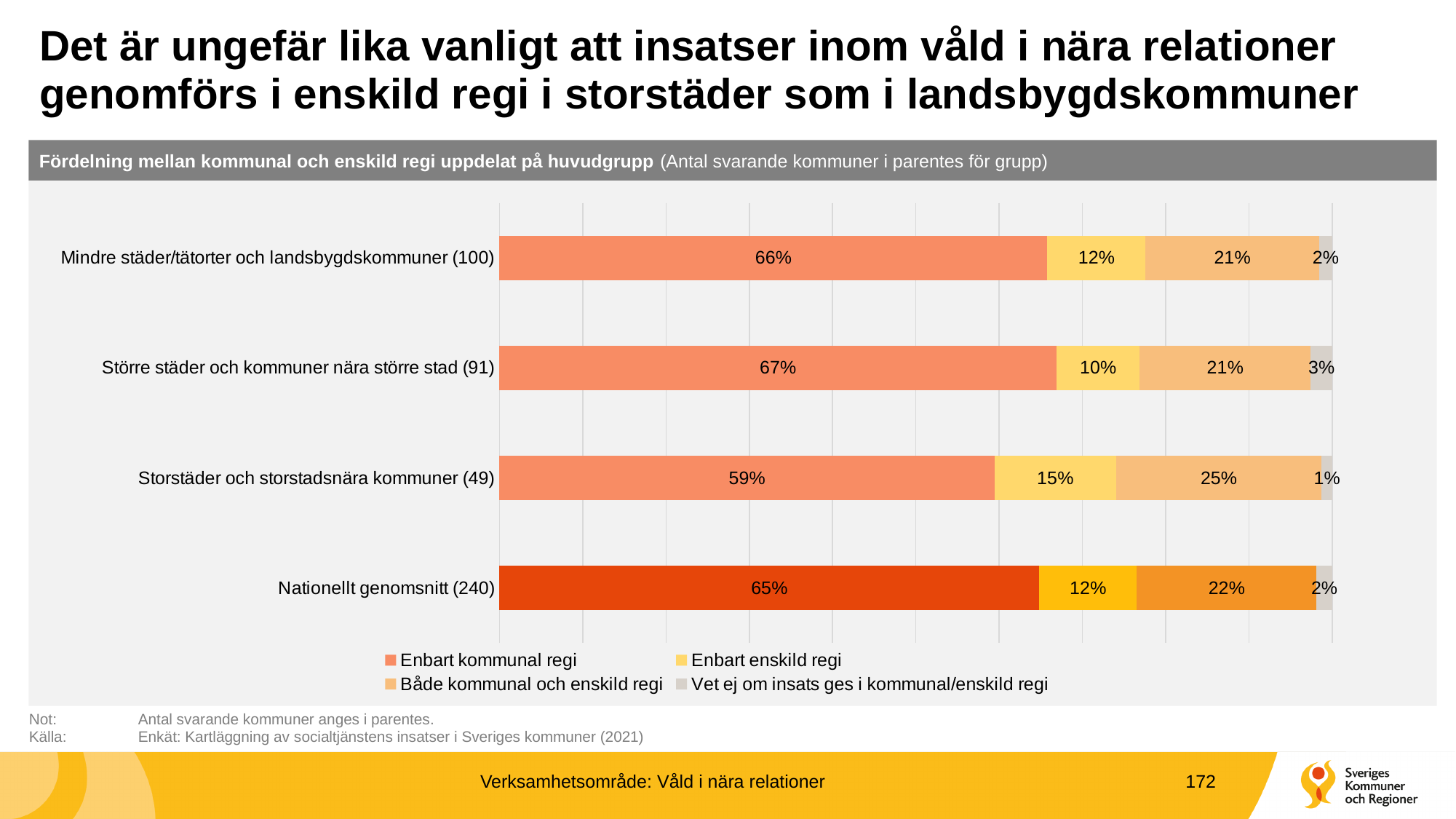
Which has a larger value for Både kommunal och enskild regi: Storstäder och storstadsnära kommuner (49) or Mindre städer/tätorter och landsbygdskommuner (100)? Storstäder och storstadsnära kommuner (49) What is the difference in Enbart enskild regi between Storstäder och storstadsnära kommuner (49) and Större städer och kommuner nära större stad (91)? 5 percentage points What is the value for Både kommunal och enskild regi for Nationellt genomsnitt (240)? 22% How many categories (bars) are shown in the chart? 4 Which category has the lowest value for Enbart kommunal regi? Storstäder och storstadsnära kommuner (49) What is the value for Vet ej om insats ges i kommunal/enskild regi for Större städer och kommuner nära större stad (91)? 3% What is the total of the printed values for the Storstäder och storstadsnära kommuner (49) bar? 100% What kind of chart is shown on the slide? Stacked bar chart Which category has the highest value for Enbart kommunal regi? Större städer och kommuner nära större stad (91) What is the value for Enbart kommunal regi for Storstäder och storstadsnära kommuner (49)? 59% How many series does the legend list? 4 Which category has the highest value for Enbart enskild regi? Storstäder och storstadsnära kommuner (49)